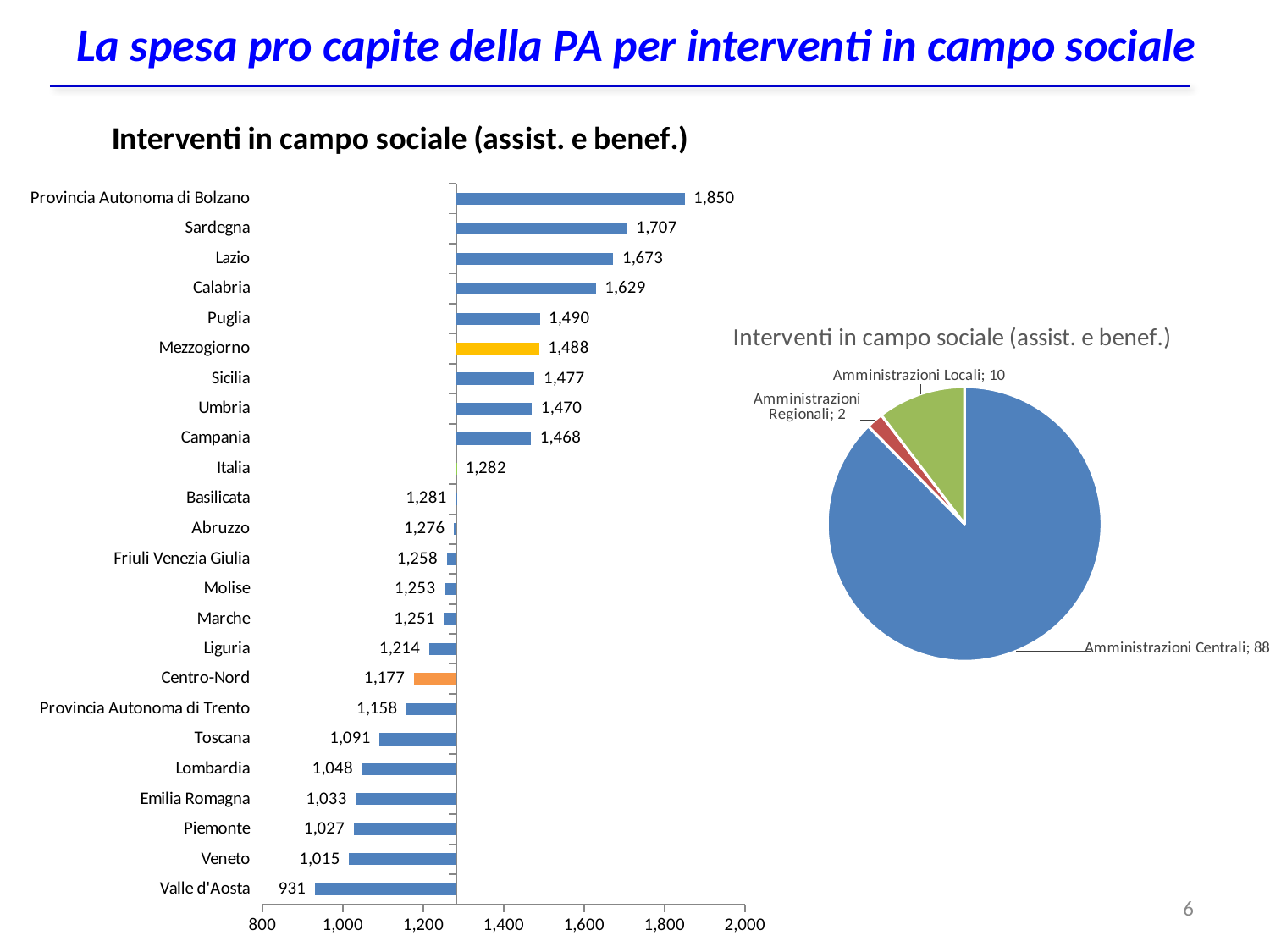
In the pie chart on the right, what share of the total does Amministrazioni Locali represent? 10% In the bar chart on the left, what is the value for Valle d'Aosta? 931 In the pie chart on the right, which slice is the smallest? Amministrazioni Regionali In the bar chart on the left, which category has the highest value? Provincia Autonoma di Bolzano In the bar chart on the left, which category has the lowest value? Valle d'Aosta In the bar chart on the left, which is larger, the value for Lazio or the value for Calabria? Lazio What kind of chart is the chart on the left of the slide? Bar chart In the bar chart on the left, what is the value for Sardegna? 1,707 In the bar chart on the left, what is the difference between the values for Mezzogiorno and Centro-Nord? 311 In the pie chart on the right, what is the value for Amministrazioni Centrali? 88 In the bar chart on the left, what is the value for Italia? 1,282 In the bar chart on the left, how many categories are plotted? 24